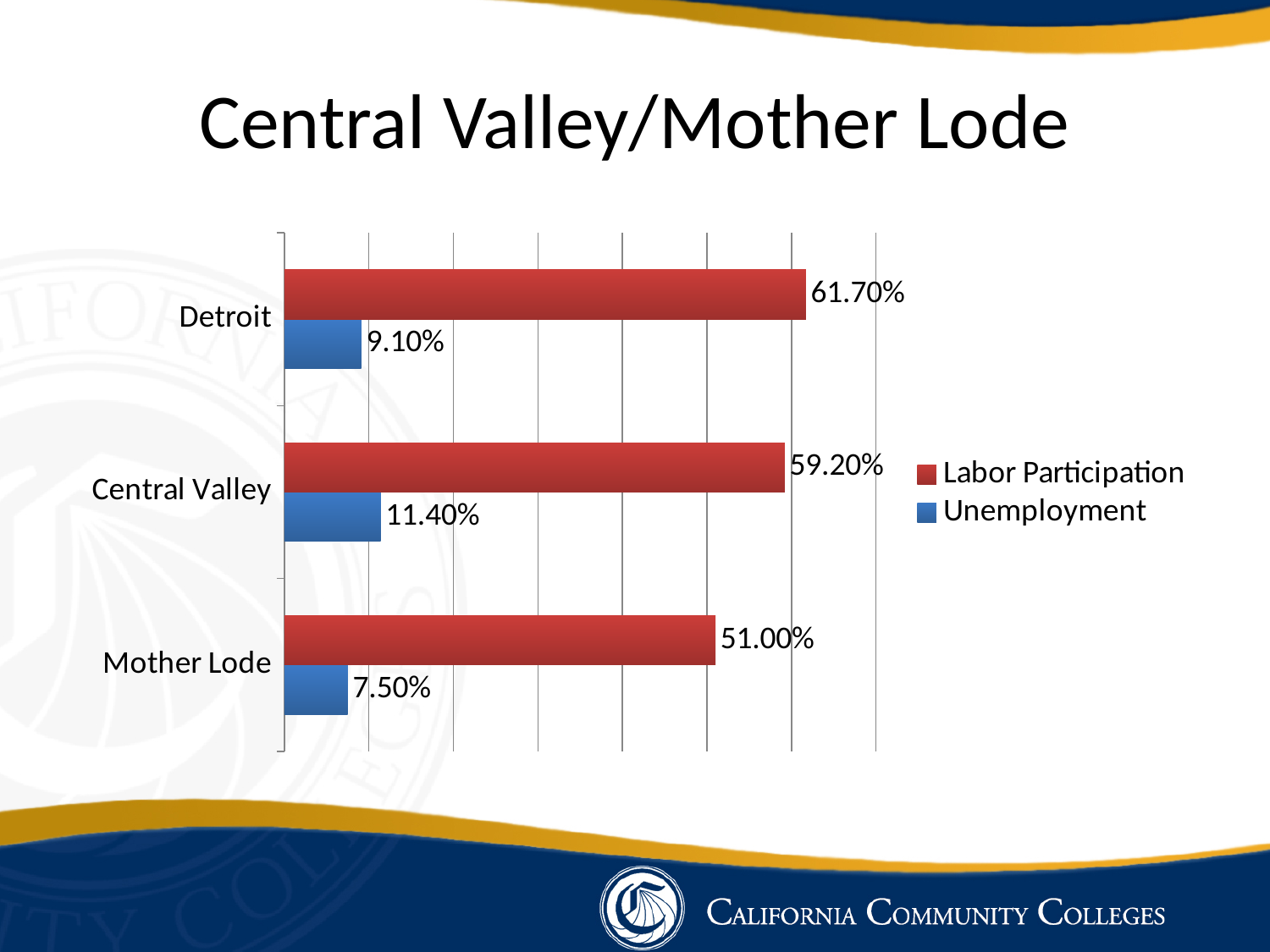
Which region has the highest Unemployment value? Central Valley How many series does the legend list? 2 What is the Unemployment value for Mother Lode? 7.50% What is the Labor Participation value for Detroit? 61.70% Which is larger, the Unemployment value for Detroit or for Mother Lode? Detroit Which region has the lowest Labor Participation value? Mother Lode What is the Unemployment value for Central Valley? 11.40% What is the difference between the Labor Participation values for Detroit and Central Valley? 2.50% How many regions are shown on the chart? 3 Which colour represents the Unemployment series? Blue What kind of chart is shown on the slide? Bar chart What is the Labor Participation value for Mother Lode? 51.00%